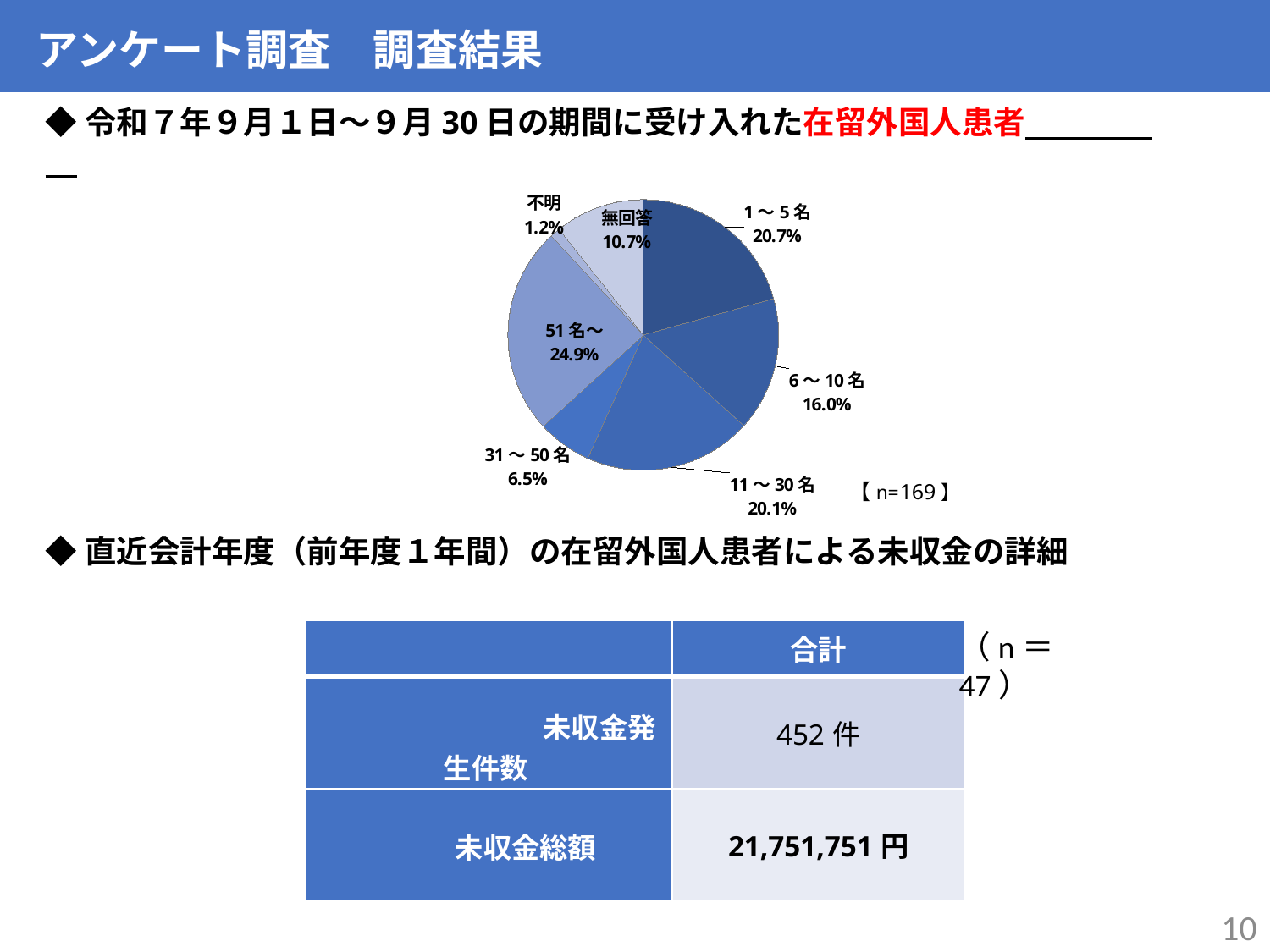
What share of the pie chart is the 無回答 slice? 10.7% What share of the pie chart is the 11～30名 slice? 20.1% What share of the pie chart is the 1～5名 slice? 20.7% Which category has the largest slice in the pie chart? 51名～ What kind of chart is shown on the slide? pie chart What is the difference in percentage points between the 51名～ slice and the 31～50名 slice? 18.4 Which slice is larger in the pie chart, 1～5名 or 6～10名? 1～5名 How many slices does the pie chart have? 7 Which category has the smallest slice in the pie chart? 不明